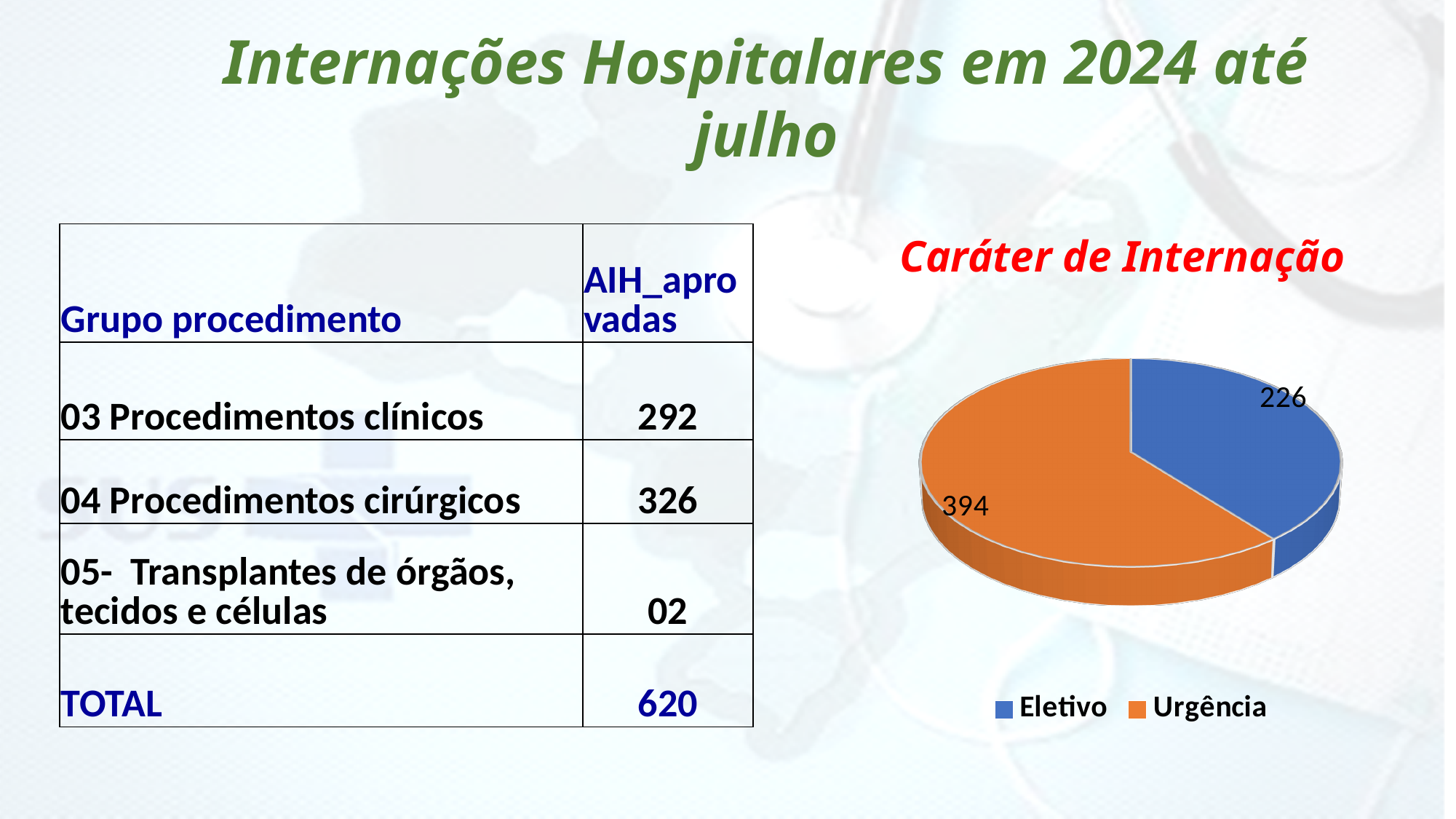
Which category has the smallest slice in the "Caráter de Internação" pie chart? Eletivo In the "Caráter de Internação" pie chart, what is the value for Urgência? 394 What type of chart is shown under the title "Caráter de Internação"? pie chart How many slices does the "Caráter de Internação" pie chart have? 2 How many entries does the legend of the "Caráter de Internação" pie chart list? 2 In the "Caráter de Internação" pie chart, which is larger, Eletivo or Urgência? Urgência In the "Caráter de Internação" pie chart, what is the value for Eletivo? 226 What is the total of the two slices in the "Caráter de Internação" pie chart? 620 In the "Caráter de Internação" pie chart, what is the difference between the Urgência and Eletivo values? 168 What is the title of the pie chart on the slide? Caráter de Internação What colour is the Urgência slice in the "Caráter de Internação" pie chart? orange Which category has the largest slice in the "Caráter de Internação" pie chart? Urgência